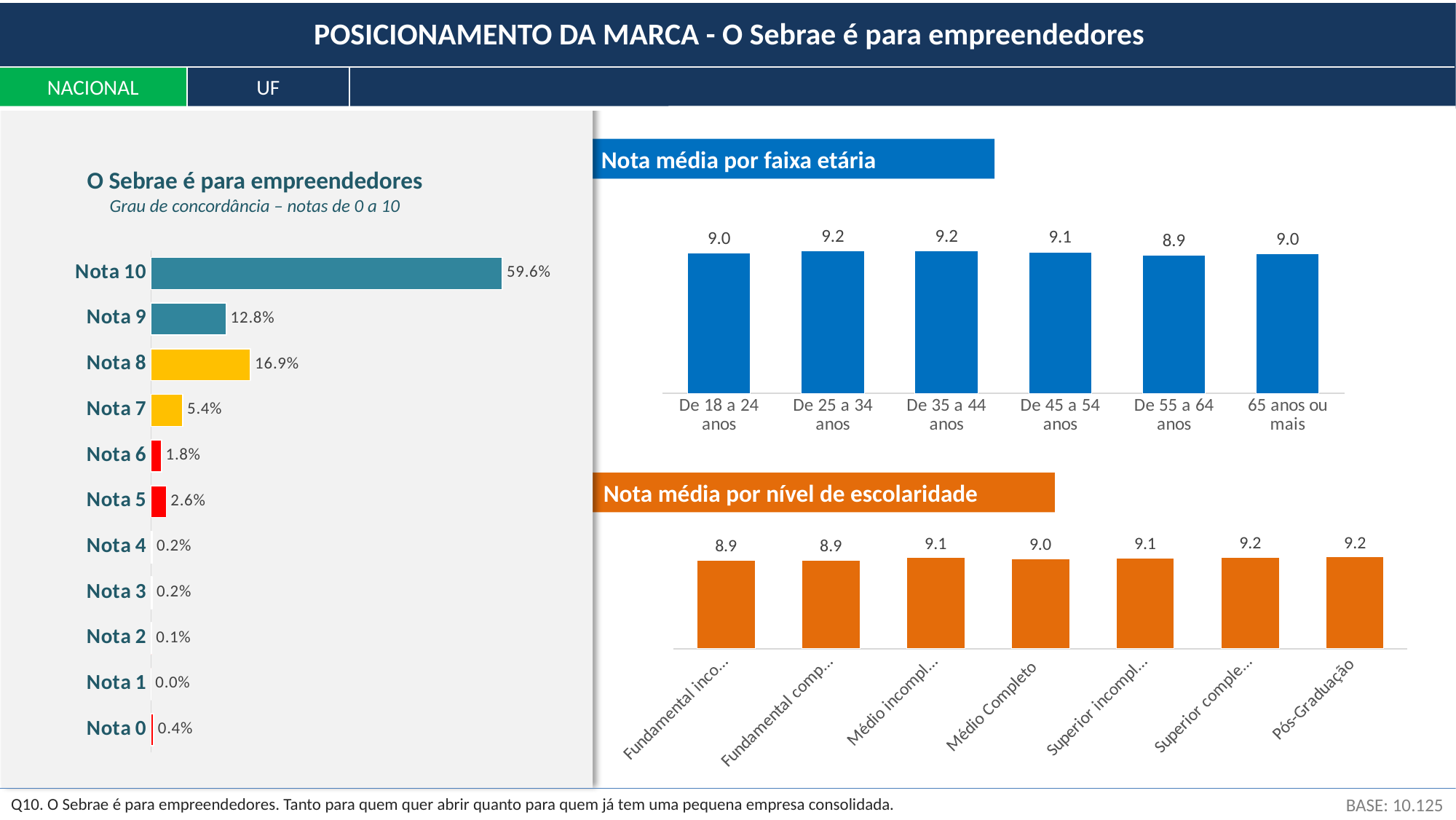
How many age groups are shown in the chart 'Nota média por faixa etária'? 6 In the chart 'Nota média por faixa etária', what is the value for 'De 55 a 64 anos'? 8.9 How many Nota categories are shown in the chart 'O Sebrae é para empreendedores'? 11 In the chart 'O Sebrae é para empreendedores', which Nota has the highest percentage? Nota 10 In the chart 'O Sebrae é para empreendedores', what percentage is shown for Nota 8? 16.9% In the chart 'O Sebrae é para empreendedores', which is larger, the percentage for Nota 9 or for Nota 8? Nota 8 In the chart 'O Sebrae é para empreendedores', what percentage is shown for Nota 10? 59.6% In the chart 'O Sebrae é para empreendedores', what is the difference between the percentages for Nota 10 and Nota 9? 46.8% In the chart 'Nota média por nível de escolaridade', what is the value for 'Pós-Graduação'? 9.2 In the chart 'Nota média por nível de escolaridade', what is the value for 'Médio Completo'? 9.0 What kind of chart is 'Nota média por faixa etária'? Bar chart In the chart 'Nota média por faixa etária', which age group has the lowest value? De 55 a 64 anos